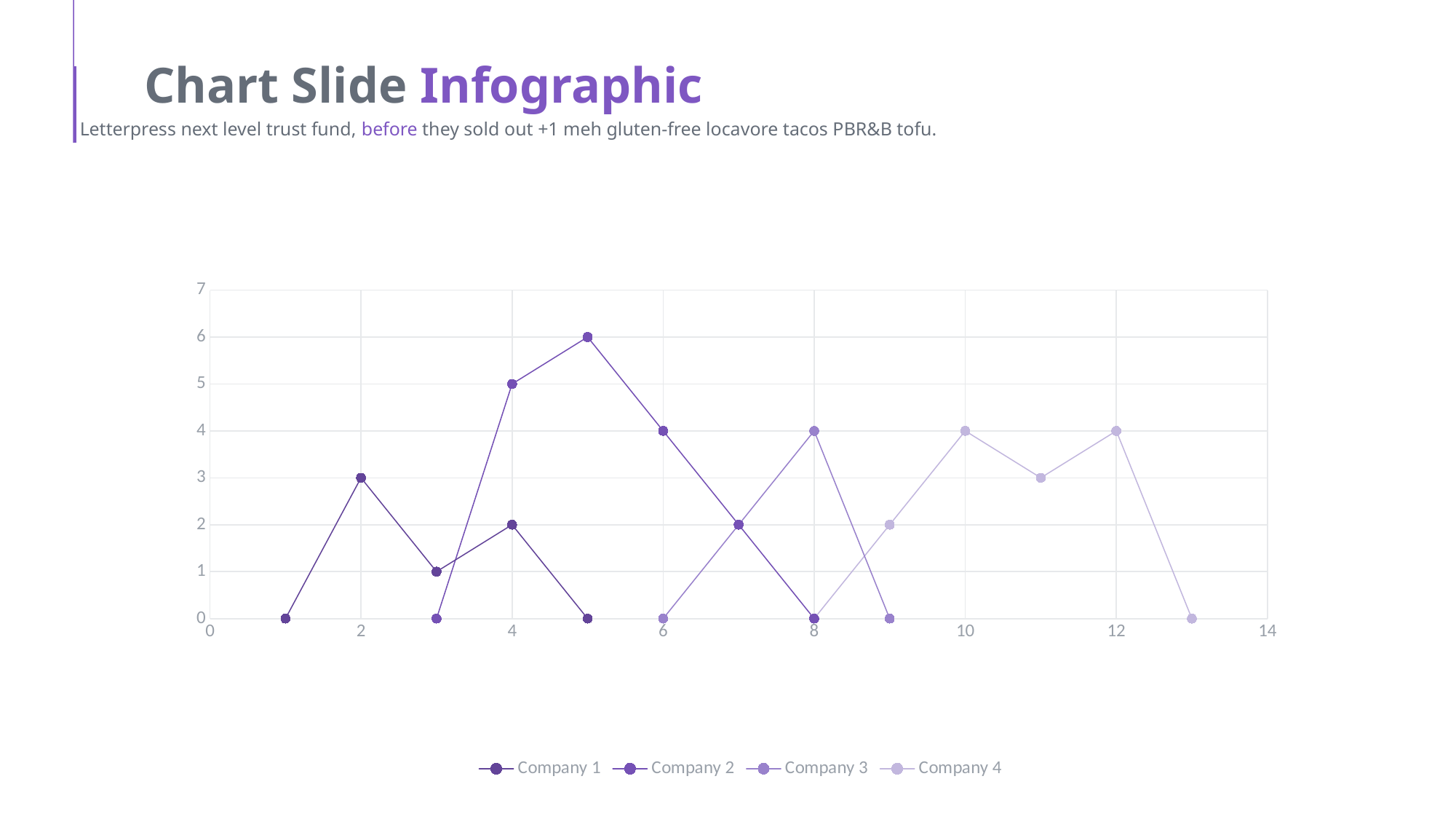
At x = 4, which is larger: the value for Company 1 or the value for Company 2? Company 2 At x = 4, what is the value for Company 2? 5 What is the difference between Company 2's value at x = 5 and Company 1's value at x = 2? 3 Which series reaches the highest value on the chart? Company 2 What is the highest value reached by Company 3? 4 What kind of chart is shown on the slide? line chart At x = 11, what is the value for Company 4? 3 What is the maximum value shown on the vertical axis? 7 How many data points are plotted for Company 4? 6 At x = 2, what is the value for Company 1? 3 How many series does the legend list? 4 What is the highest value reached by Company 2? 6